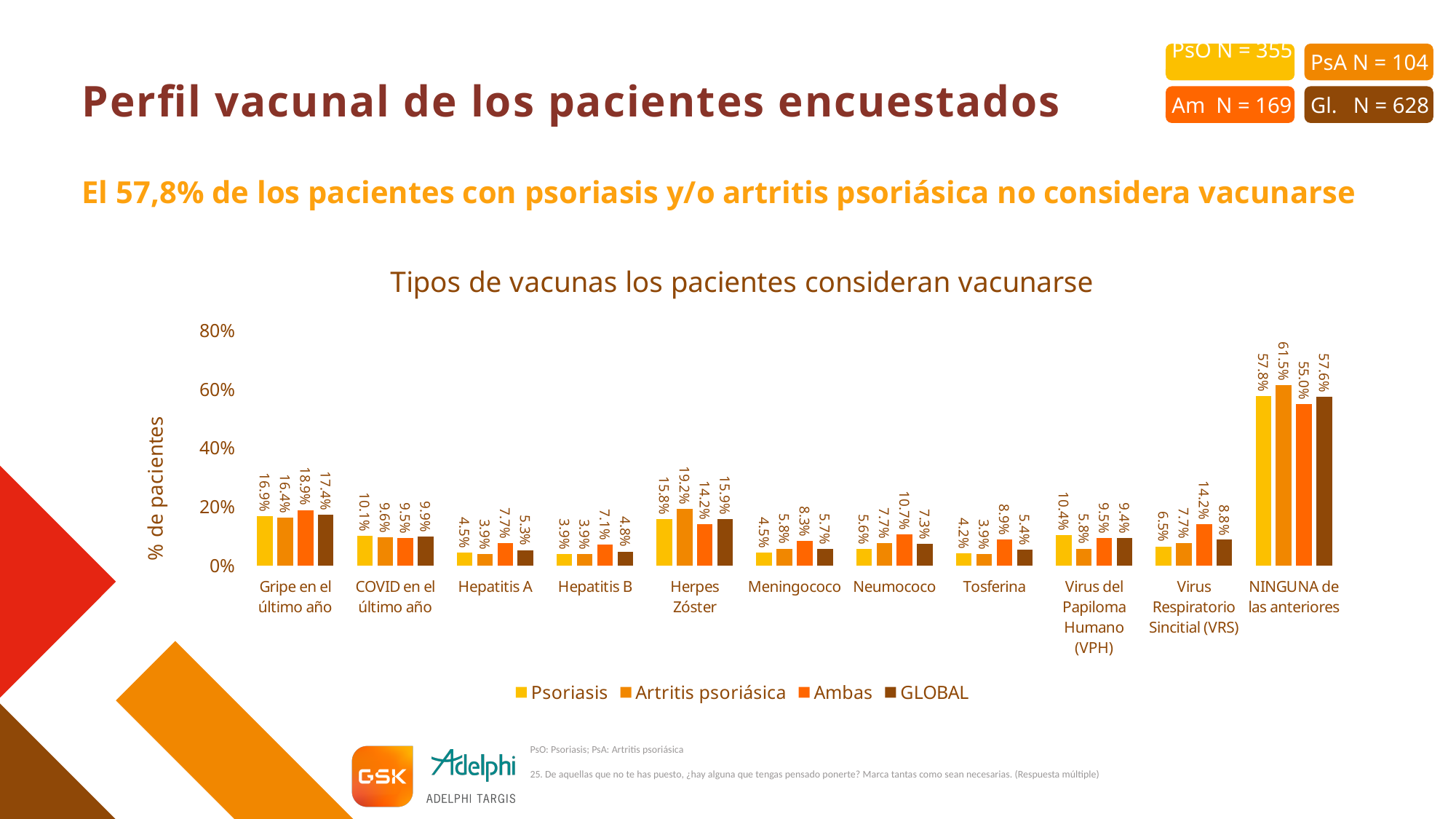
What is the GLOBAL value for Gripe en el último año? 17.4% Which category has the lowest Ambas value? Hepatitis B What is the Ambas value for Virus Respiratorio Sincitial (VRS)? 14.2% What is the Psoriasis value for NINGUNA de las anteriores? 57.8% Which category has the highest GLOBAL value? NINGUNA de las anteriores How many vaccine categories are shown on the x axis? 11 How many series does the legend list? 4 What kind of chart is shown on the slide? Bar chart What is the title of the chart? Tipos de vacunas los pacientes consideran vacunarse What is the Artritis psoriásica value for Herpes Zóster? 19.2% What is the difference between the Artritis psoriásica and Ambas values for NINGUNA de las anteriores? 6.5% For Neumococo, which is larger: the Psoriasis value or the Ambas value? Ambas